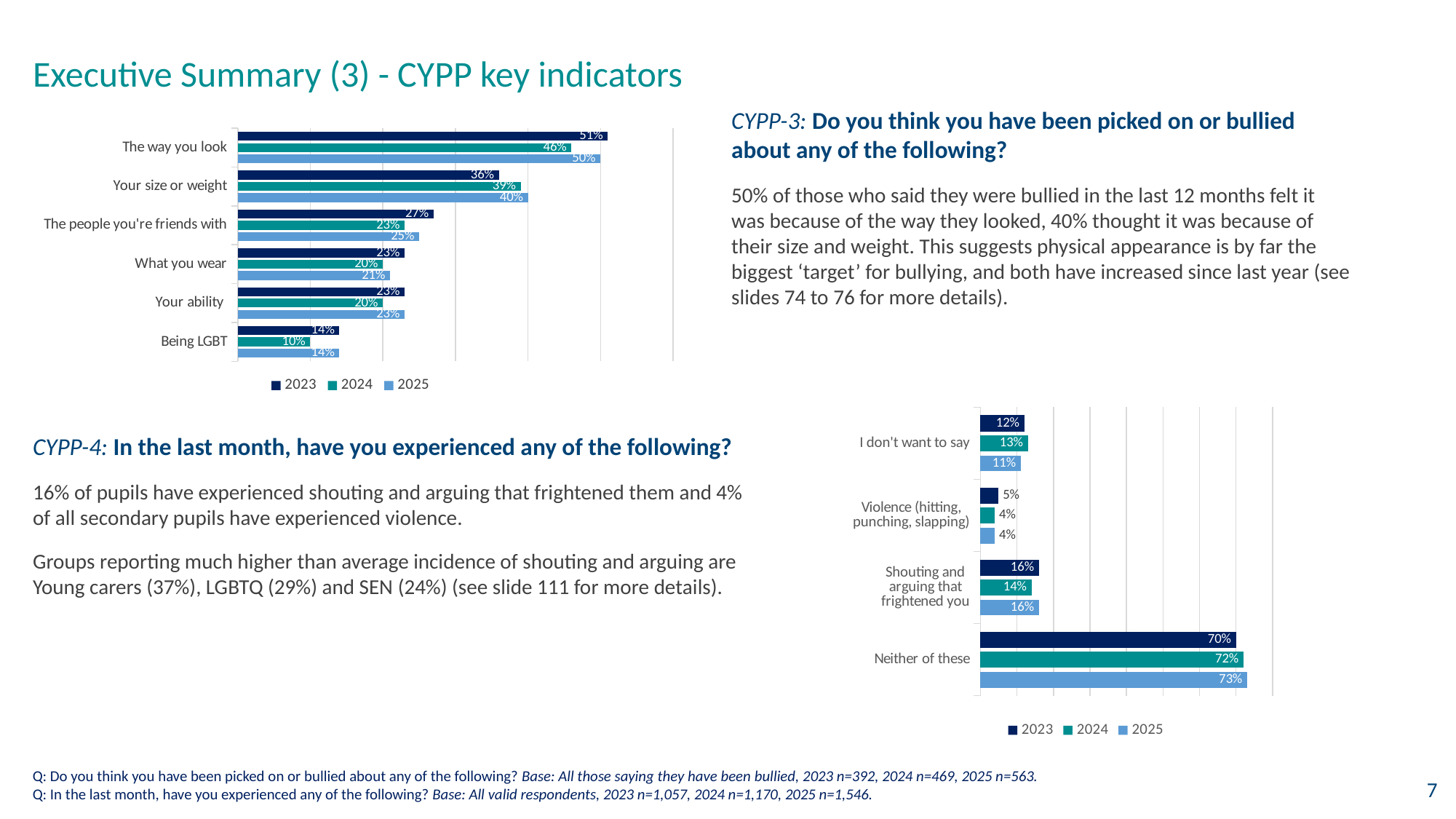
In the bottom-right chart, what is the difference between the 2025 and 2023 values for 'Neither of these'? 3% In the bottom-right chart, which category has the highest 2023 value? Neither of these In the top-left chart, how many categories are shown? 6 In the bottom-right chart, what is the 2023 value for 'Violence (hitting, punching, slapping)'? 5% In the bottom-right chart, is the 2024 value for 'Shouting and arguing that frightened you' larger or smaller than the 2025 value? smaller In the top-left chart, what is the difference between the 2023 and 2024 values for 'The way you look'? 5% In the top-left chart, how many series does the legend list? 3 In the top-left chart, what is the 2025 value for 'The way you look'? 50% What type of chart is the bottom-right chart? bar chart In the bottom-right chart, what is the 2025 value for 'Neither of these'? 73% In the top-left chart, which category has the lowest 2024 value? Being LGBT In the top-left chart, what is the 2024 value for 'Your size or weight'? 39%